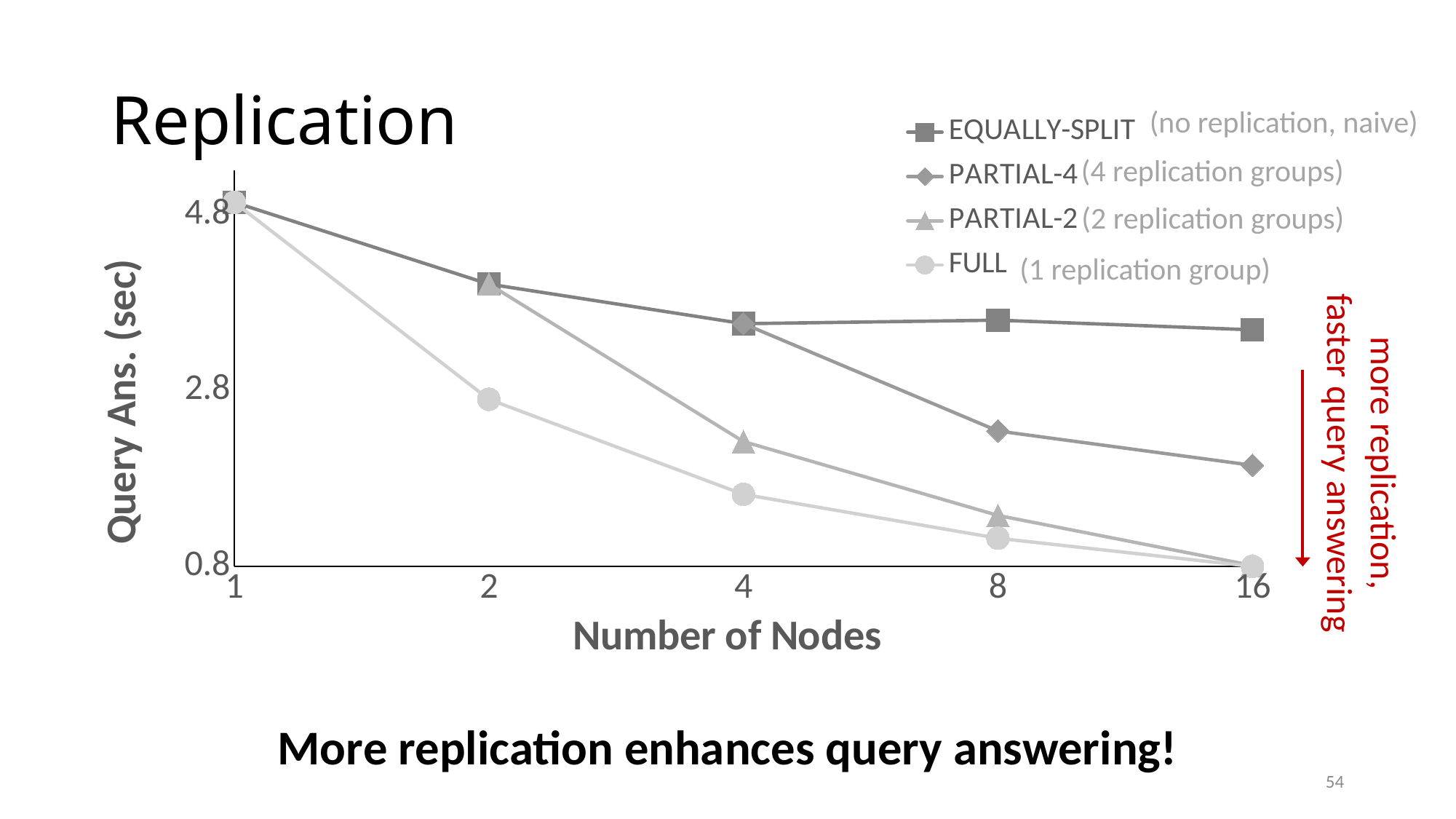
At 16 nodes, which is larger: the value for EQUALLY-SPLIT or the value for PARTIAL-4? EQUALLY-SPLIT How many series does the legend list? 4 At 4 nodes, which is larger: the value for PARTIAL-2 or the value for FULL? PARTIAL-2 What kind of chart is shown on the slide? line chart Does the FULL series rise or fall as the number of nodes increases? fall Which series has the highest query answering time at 16 nodes? EQUALLY-SPLIT Is the value for FULL at 4 nodes greater or less than 2.8? less Is the value for PARTIAL-4 at 8 nodes greater or less than 2.8? less What is the title of the x axis? Number of Nodes Is the value for EQUALLY-SPLIT at 16 nodes greater or less than 2.8? greater Which series has the lowest query answering time at 4 nodes? FULL How many node counts are plotted along the x axis? 5